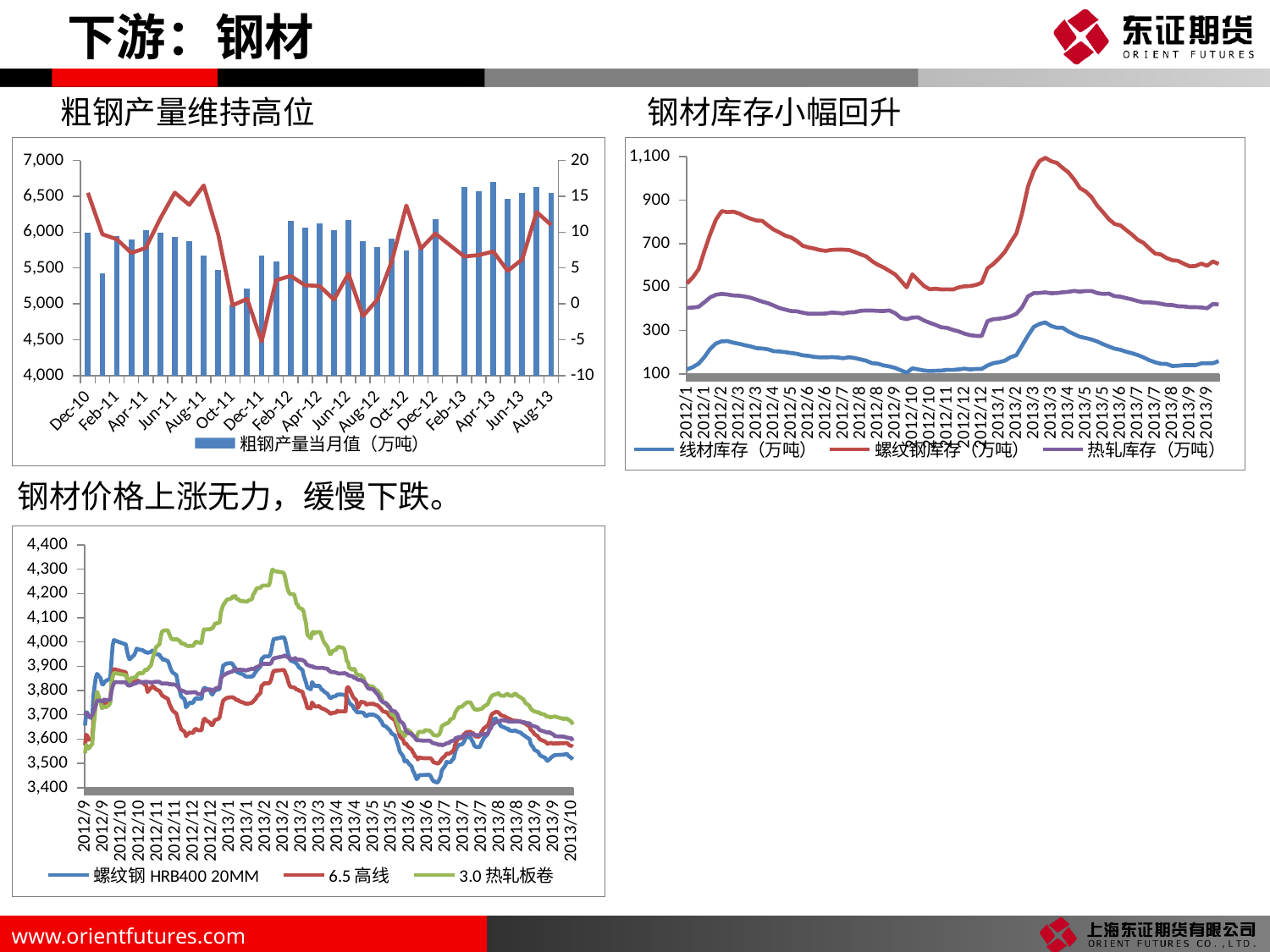
What is the legend entry shown for the bars in the top-left chart (粗钢产量维持高位)? 粗钢产量当月值（万吨） In the top-right chart (钢材库存小幅回升), is the value of 线材库存（万吨） at 2012/1 greater or less than 300? less In the top-right chart (钢材库存小幅回升), is the peak value of 螺纹钢库存（万吨） greater or less than 900? greater In the top-left chart (粗钢产量维持高位), is the bar for Dec-10 greater or less than 5,500 on the left axis? greater In the bottom-left chart (钢材价格上涨无力，缓慢下跌), does the 螺纹钢 HRB400 20MM series rise or fall from 2013/2 to 2013/7? fall How many series does the legend of the top-right chart (钢材库存小幅回升) list? 3 What kind of chart is the top-right chart titled 钢材库存小幅回升? line chart In the top-right chart (钢材库存小幅回升), which series has the lowest values throughout the period? 线材库存（万吨） How many series does the legend of the bottom-left chart (钢材价格上涨无力，缓慢下跌) list? 3 In the top-right chart (钢材库存小幅回升), which series has the highest values throughout the period? 螺纹钢库存（万吨）